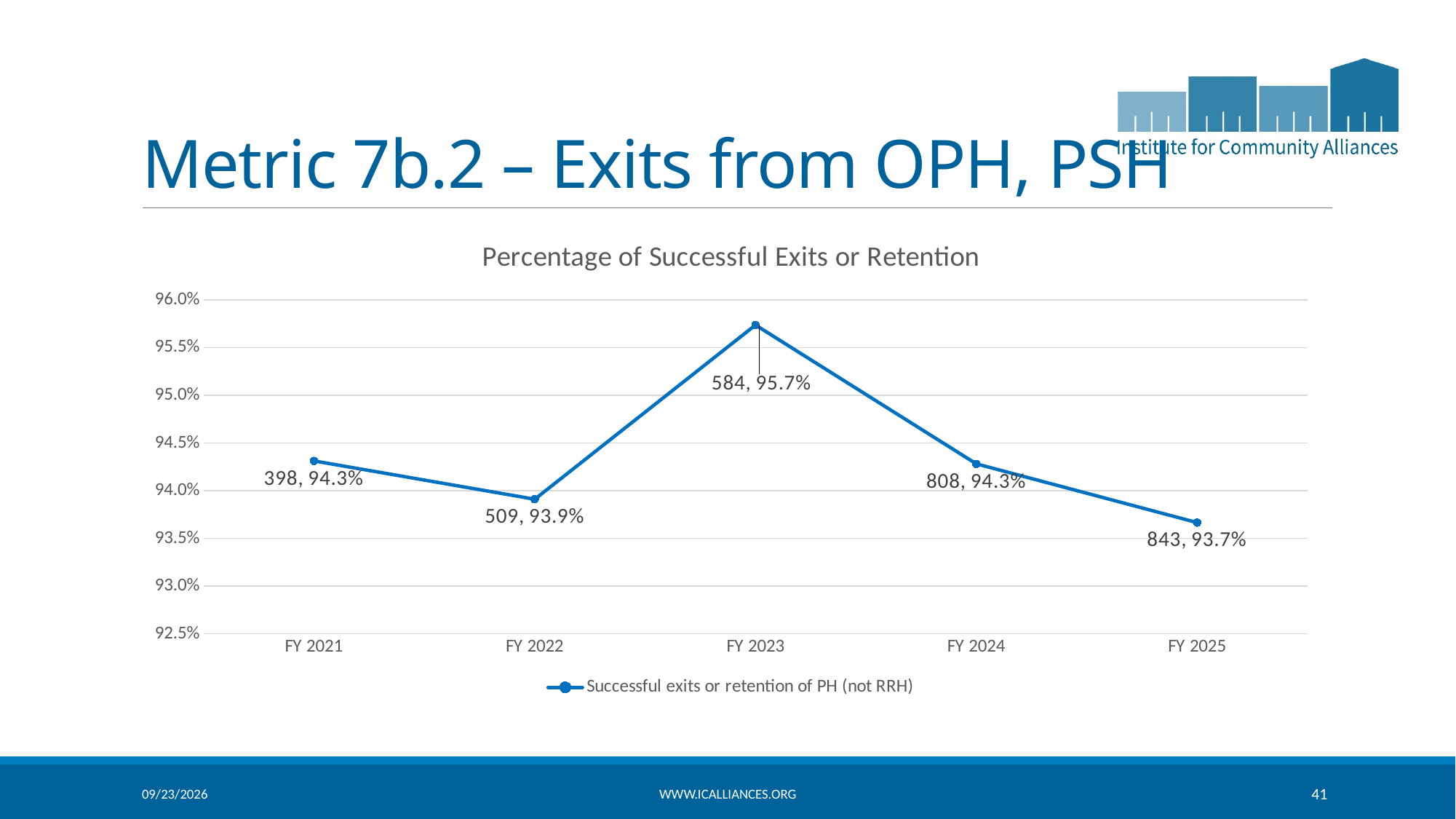
Which fiscal year has the lowest percentage of successful exits or retention? FY 2025 What count is shown in the data label for FY 2024? 808 What percentage is shown for FY 2023? 95.7% What kind of chart is shown on the slide? line chart How many fiscal years are plotted on the chart? 5 Which fiscal year has the highest percentage of successful exits or retention? FY 2023 What is the title of the chart? Percentage of Successful Exits or Retention What is the difference in percentage points between FY 2023 and FY 2022? 1.8% Which is larger, the percentage for FY 2022 or FY 2024? FY 2024 How many series does the legend list? 1 Is the value for FY 2023 greater or less than 95.0%? greater What percentage is shown for FY 2025? 93.7%